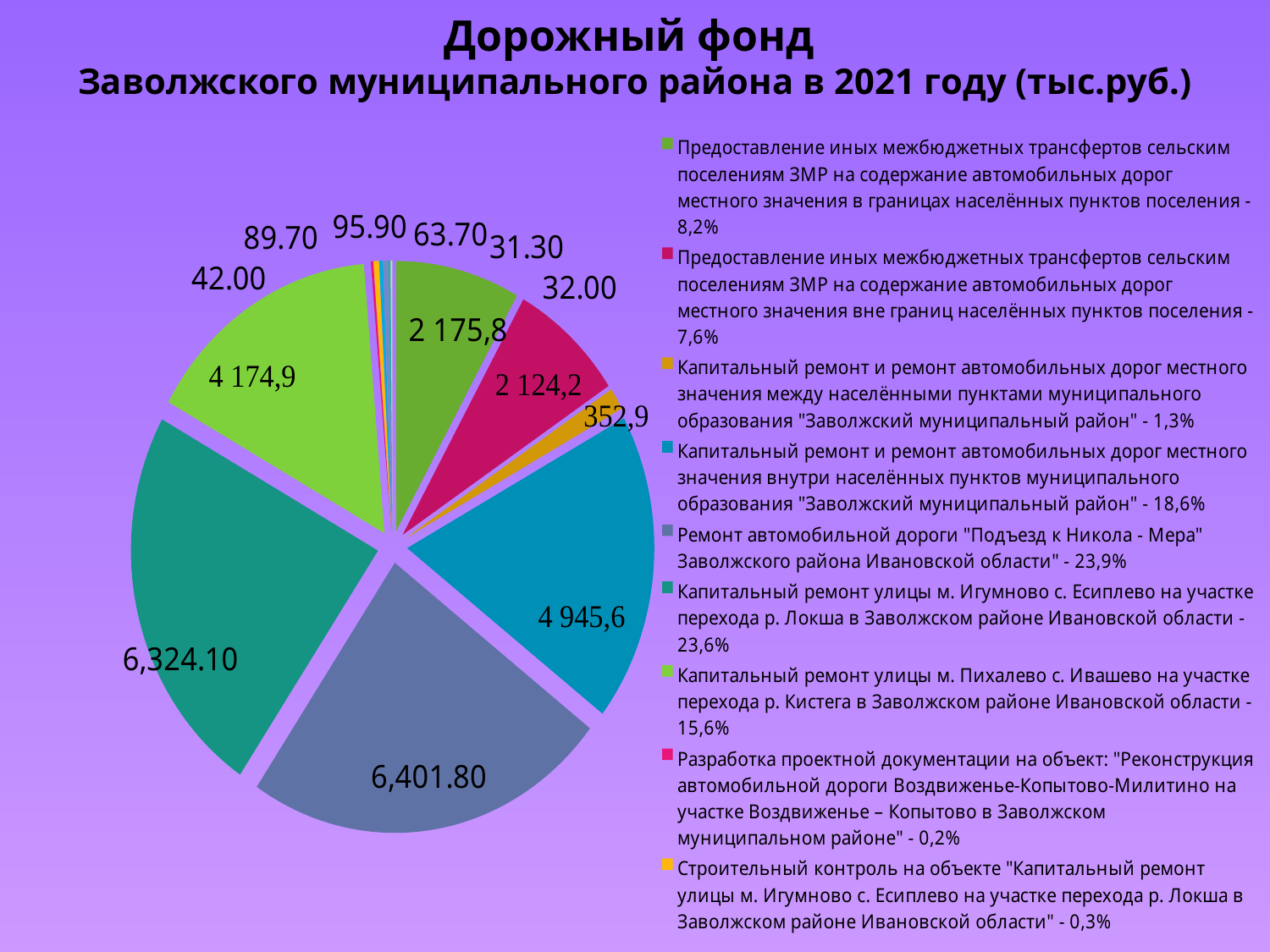
According to the legend, what share of the pie does Ремонт автомобильной дороги "Подъезд к Никола - Мера" represent? 23,9% Which category has the largest slice of the pie? Ремонт автомобильной дороги "Подъезд к Никола - Мера" Заволжского района Ивановской области What is the value of the slice for Капитальный ремонт и ремонт автомобильных дорог местного значения внутри населённых пунктов муниципального образования? 4 945,6 What kind of chart is shown on the slide? pie chart What is the value of the slice for Капитальный ремонт улицы м. Пихалево с. Ивашево на участке перехода р. Кистега? 4 174,9 What is the value of the slice for Капитальный ремонт и ремонт автомобильных дорог местного значения между населёнными пунктами муниципального образования? 352,9 What is the title of the chart on the slide? Дорожный фонд Заволжского муниципального района в 2021 году (тыс.руб.) What is the value of the slice for Капитальный ремонт улицы м. Игумново с. Есиплево на участке перехода р. Локша? 6,324.10 What is the value of the slice for Ремонт автомобильной дороги "Подъезд к Никола - Мера" Заволжского района Ивановской области? 6,401.80 What is the value of the slice for Предоставление иных межбюджетных трансфертов сельским поселениям ЗМР на содержание автомобильных дорог местного значения в границах населённых пунктов поселения? 2 175,8 Which is larger: the slice for Капитальный ремонт и ремонт автомобильных дорог внутри населённых пунктов (4 945,6) or the slice for Капитальный ремонт улицы м. Пихалево с. Ивашево (4 174,9)? Капитальный ремонт и ремонт автомобильных дорог внутри населённых пунктов (4 945,6) What is the difference between the slice labelled 6,401.80 and the slice labelled 6,324.10? 77.70